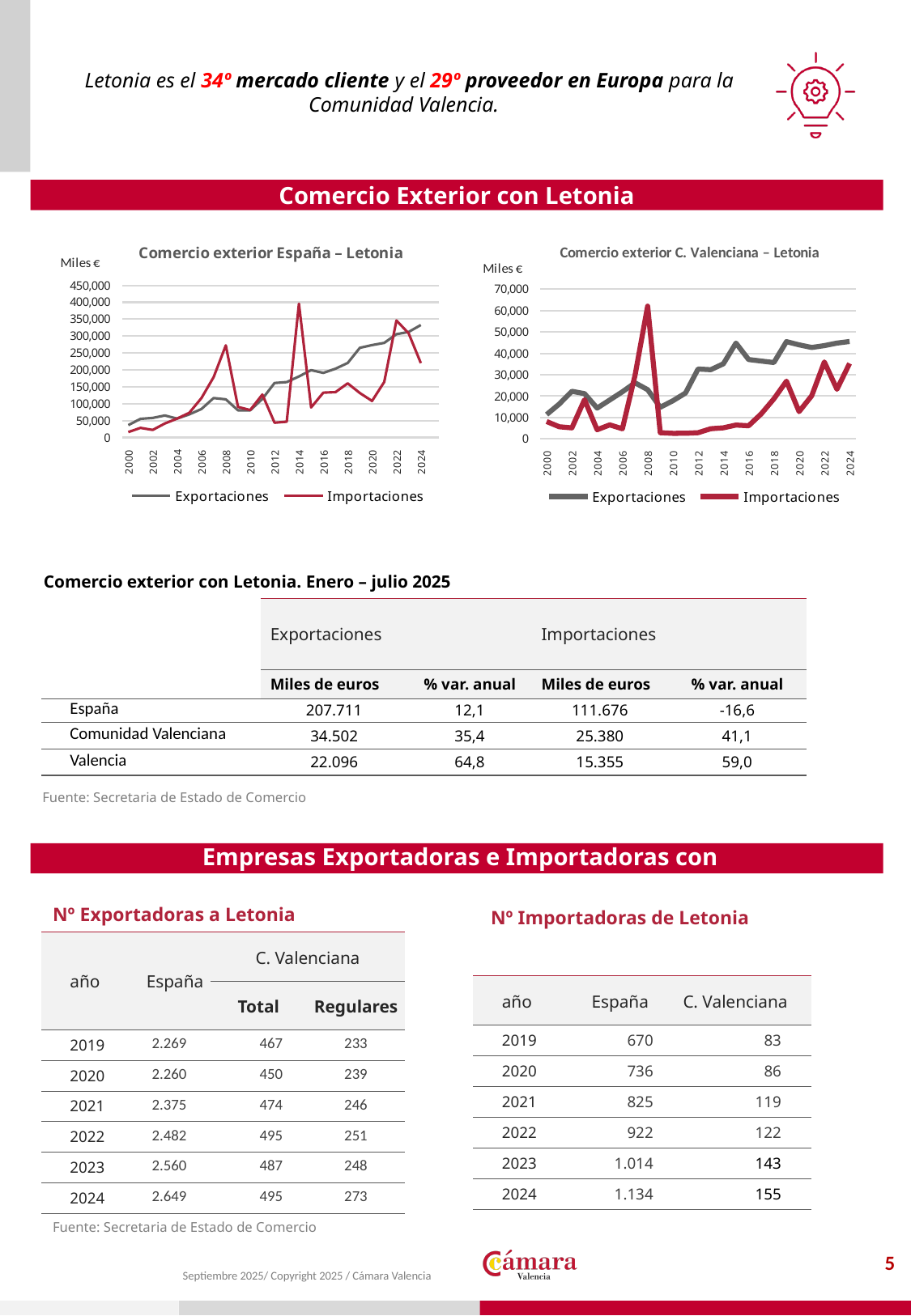
In 'Comercio exterior C. Valenciana – Letonia', which series is higher in 2024, Exportaciones or Importaciones? Exportaciones In 'Comercio exterior España – Letonia', is the Exportaciones value for 2024 greater or less than 300,000? greater What are the two series named in the legend of 'Comercio exterior España – Letonia'? Exportaciones and Importaciones What kind of chart is 'Comercio exterior España – Letonia'? line chart In 'Comercio exterior España – Letonia', which series is higher in 2024, Exportaciones or Importaciones? Exportaciones How many series does the legend of 'Comercio exterior C. Valenciana – Letonia' list? 2 In 'Comercio exterior España – Letonia', do Exportaciones generally rise or fall from 2000 to 2024? rise In 'Comercio exterior España – Letonia', in which year does Importaciones reach its highest value? 2014 In 'Comercio exterior C. Valenciana – Letonia', is the Importaciones value for 2008 greater or less than 50,000? greater In 'Comercio exterior C. Valenciana – Letonia', is the Exportaciones value for 2024 greater or less than 40,000? greater In 'Comercio exterior C. Valenciana – Letonia', in which year does Importaciones reach its highest value? 2008